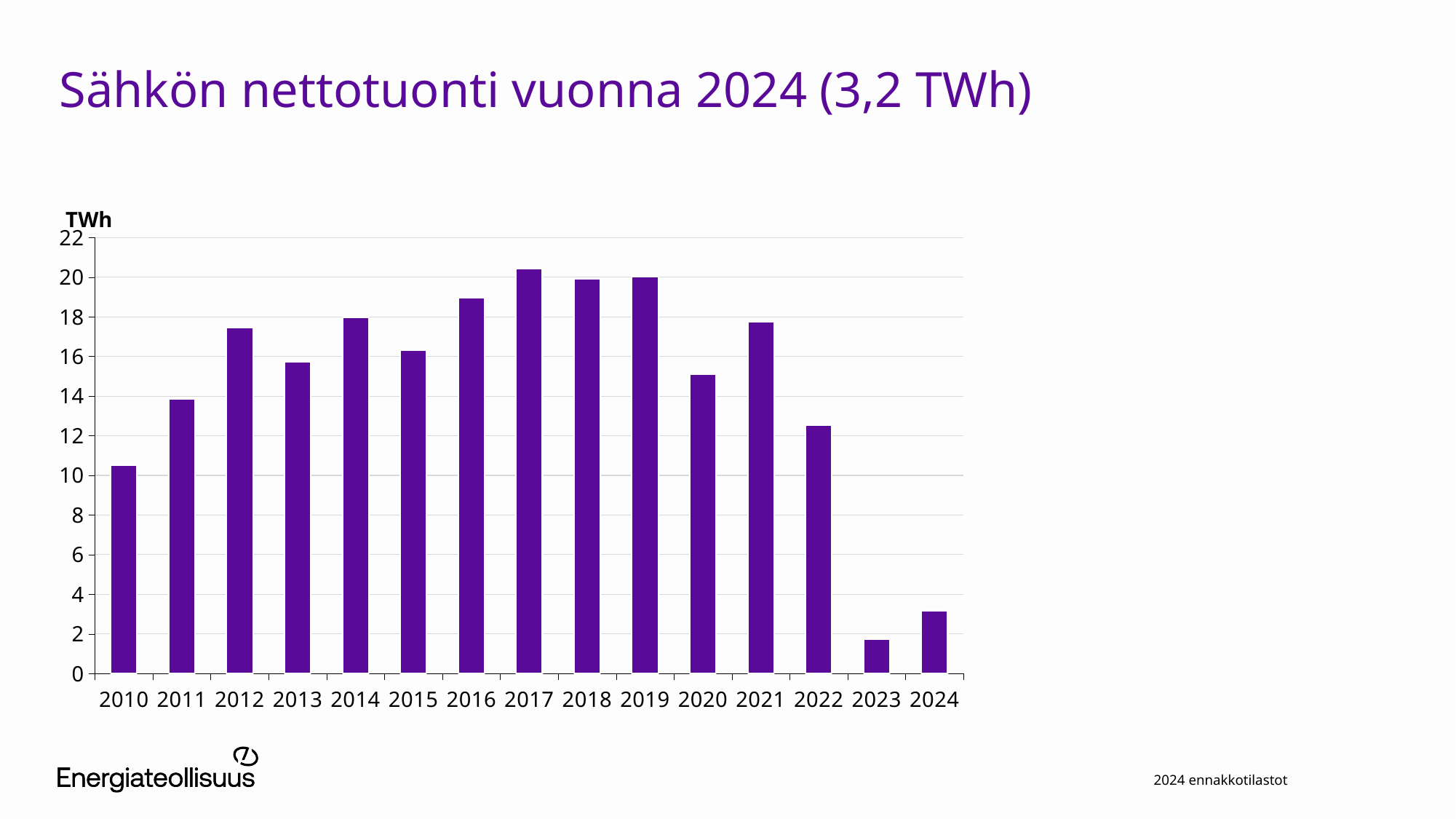
How many years are shown on the x axis of the chart? 15 Is the value for 2016 greater or less than 18? greater What is the net import of electricity in 2024 according to the slide? 3,2 TWh What kind of chart is shown on the slide? bar chart Which year has the highest net import value in the chart? 2017 Is the value for 2023 greater or less than 2? less Is the value for 2010 greater or less than 10? greater Which year has the lowest net import value in the chart? 2023 Do the values rise or fall from 2019 to 2023? fall What unit is shown on the vertical axis of the chart? TWh Which year has the larger value, 2021 or 2022? 2021